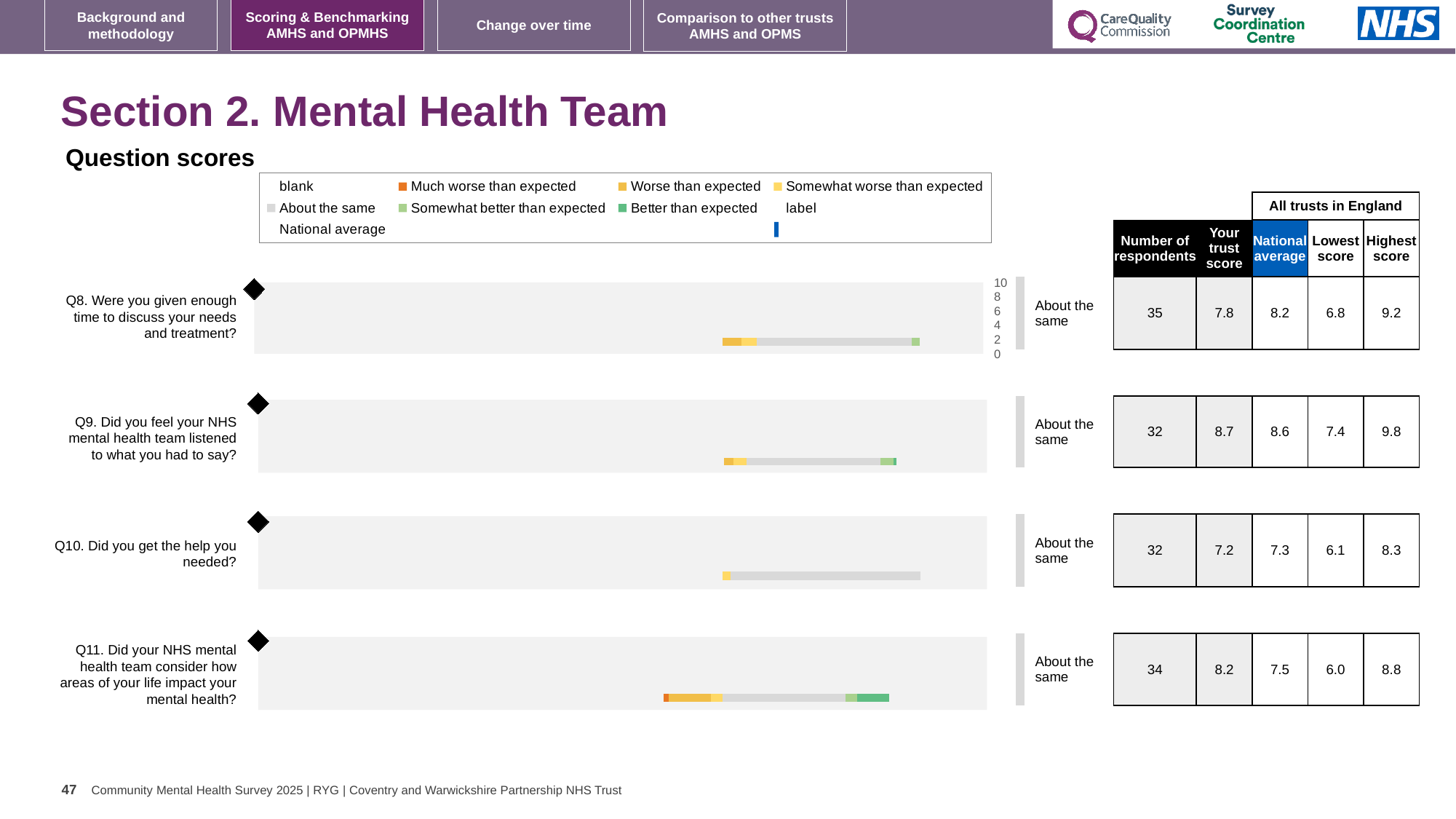
For the Q8 chart, what is the lowest score among all trusts in England? 6.8 Which question has the highest 'Your trust score' on this slide? Q9 For Q11, what is the difference between the trust score and the national average? 0.7 What kind of chart is used for each question (Q8 to Q11) on this slide? Bar chart For the Q9 chart (mental health team listened), what is the 'Your trust score' value? 8.7 In the legend, what does the blue vertical marker represent? National average For the Q8 chart (time to discuss needs and treatment), what is the number of respondents shown in the table? 35 How many question charts are shown on the slide? 4 Which question has the lowest 'Your trust score' on this slide? Q10 For Q8, which is larger: the trust score or the national average? National average For the Q11 chart (areas of your life impact your mental health), what is the highest score among all trusts in England? 8.8 For the Q10 chart (did you get the help you needed), what is the national average? 7.3